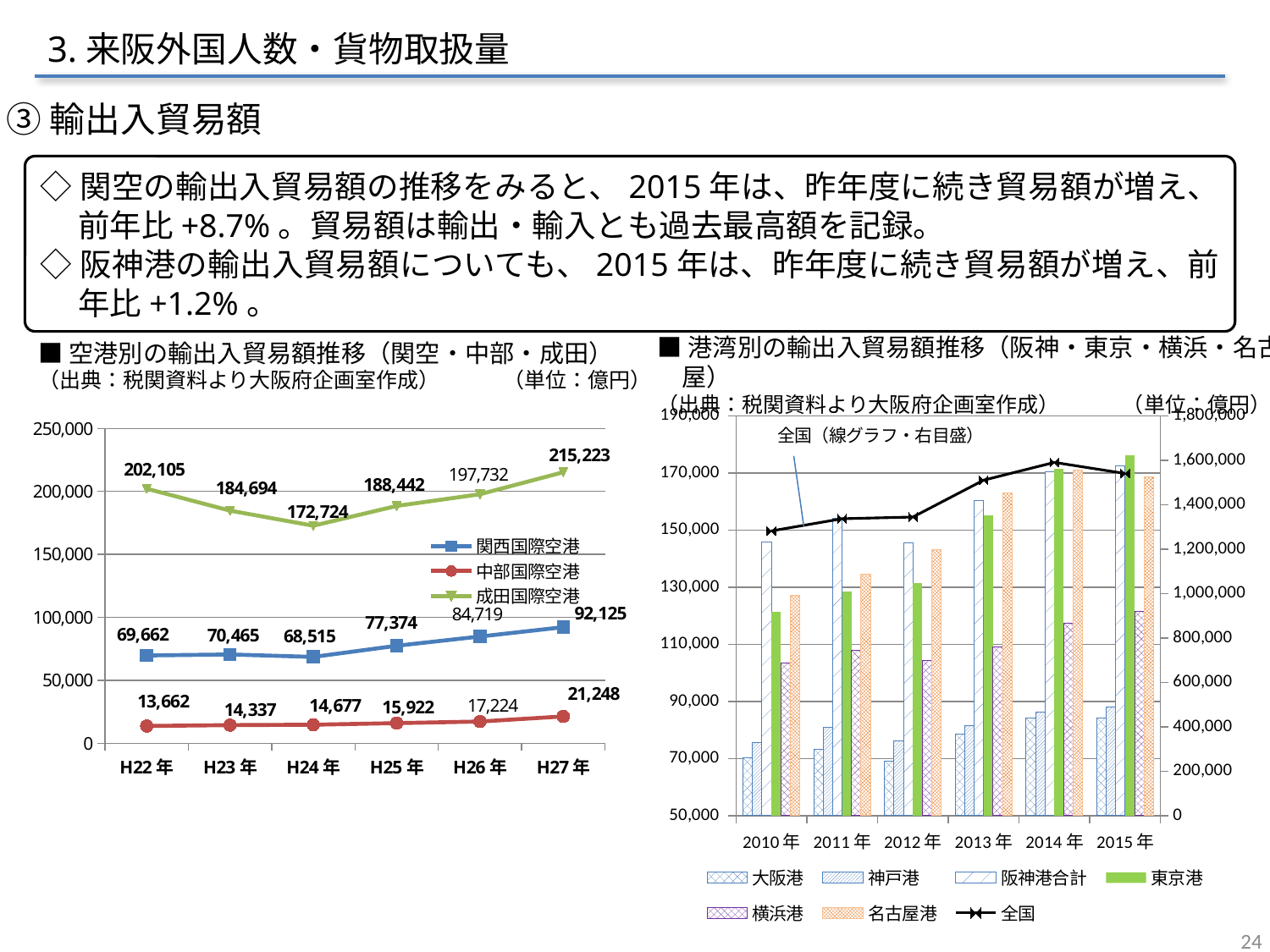
In the left chart (空港別の輸出入貿易額推移), which is larger in H23年: 関西国際空港 or 中部国際空港? 関西国際空港 In the left chart (空港別の輸出入貿易額推移), how many series does the legend list? 3 In the right chart (港湾別の輸出入貿易額推移), how many years are shown on the x axis? 6 In the left chart (空港別の輸出入貿易額推移), what kind of chart is it? Line chart In the left chart (空港別の輸出入貿易額推移), what is the value for 中部国際空港 in H22年? 13,662 In the left chart (空港別の輸出入貿易額推移), in which year is the value for 関西国際空港 the highest? H27年 In the left chart (空港別の輸出入貿易額推移), in which year is the value for 成田国際空港 the lowest? H24年 In the right chart (港湾別の輸出入貿易額推移), is the value for 阪神港合計 in 2010年 greater or less than 130,000? greater In the left chart (空港別の輸出入貿易額推移), what is the value for 関西国際空港 in H27年? 92,125 In the left chart (空港別の輸出入貿易額推移), what is the value for 成田国際空港 in H24年? 172,724 In the right chart (港湾別の輸出入貿易額推移), how many series does the legend list? 7 In the left chart (空港別の輸出入貿易額推移), what is the difference between the 成田国際空港 values in H27年 and H26年? 17,491